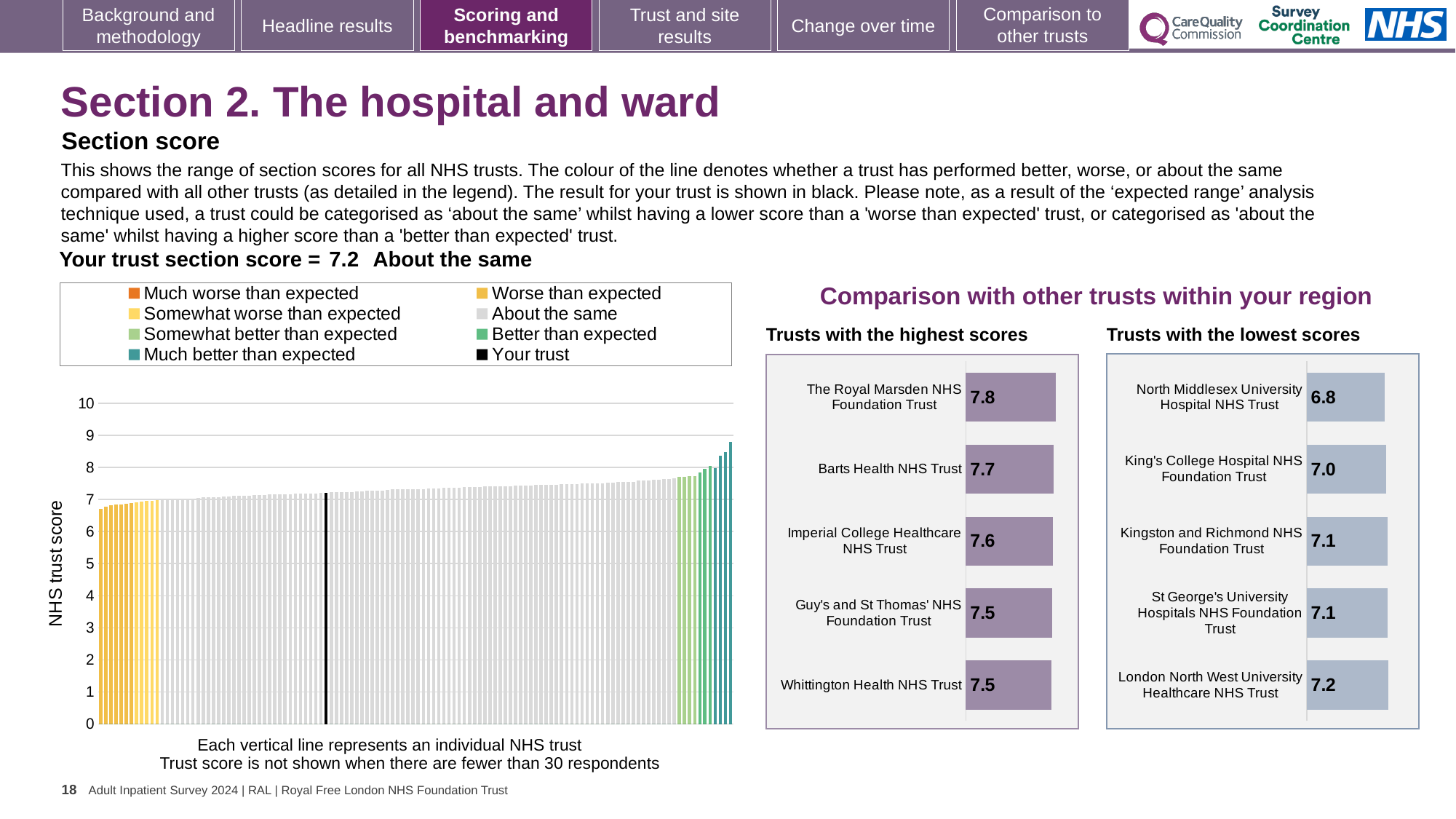
In the 'Trusts with the lowest scores' chart, what is the score for King's College Hospital NHS Foundation Trust? 7.0 In the 'Trusts with the lowest scores' chart, which trust has the lowest score? North Middlesex University Hospital NHS Trust In the 'NHS trust score' chart on the left, do the bar values rise or fall from left to right? Rise How many entries does the legend of the 'NHS trust score' chart on the left list? 8 In the 'Trusts with the lowest scores' chart, which has the larger score: North Middlesex University Hospital NHS Trust or London North West University Healthcare NHS Trust? London North West University Healthcare NHS Trust What kind of chart is the 'NHS trust score' chart on the left of the slide? Bar chart In the 'Trusts with the lowest scores' chart, what is the difference between the scores of London North West University Healthcare NHS Trust and North Middlesex University Hospital NHS Trust? 0.4 In the 'Trusts with the highest scores' chart, how many trusts are shown? 5 In the 'Trusts with the highest scores' chart, which trust has the highest score? The Royal Marsden NHS Foundation Trust In the 'NHS trust score' chart on the left, is the value of the tallest bar greater or less than 8? greater In the 'Trusts with the highest scores' chart, what is the score for The Royal Marsden NHS Foundation Trust? 7.8 In the 'Trusts with the highest scores' chart, what is the difference between the scores of The Royal Marsden NHS Foundation Trust and Whittington Health NHS Trust? 0.3